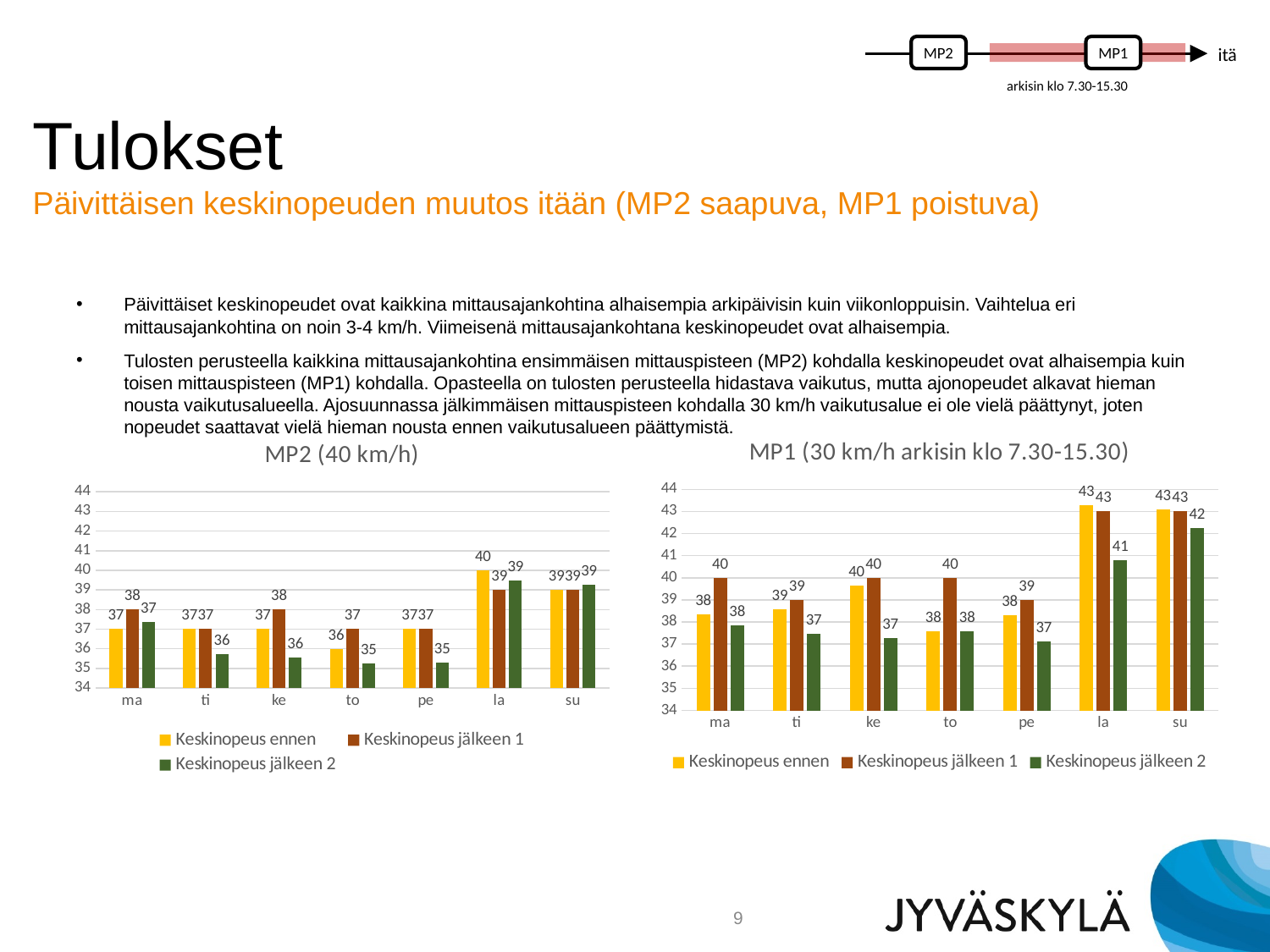
In the MP1 (30 km/h arkisin klo 7.30-15.30) chart, which day has the lowest value for Keskinopeus jälkeen 2? ti, ke and pe (all 37) In the MP2 (40 km/h) chart, what is the value of Keskinopeus jälkeen 1 for ke? 38 In the MP2 (40 km/h) chart, what is the value of Keskinopeus jälkeen 2 for to? 35 How many series does the legend of the MP1 (30 km/h arkisin klo 7.30-15.30) chart list? 3 What type of chart is the MP2 (40 km/h) chart? Bar chart How many days are shown on the x axis of the MP2 (40 km/h) chart? 7 In the MP1 (30 km/h arkisin klo 7.30-15.30) chart, what is the value of Keskinopeus jälkeen 2 for su? 42 In the MP2 (40 km/h) chart, which is larger for ma: Keskinopeus ennen or Keskinopeus jälkeen 1? Keskinopeus jälkeen 1 In the MP1 (30 km/h arkisin klo 7.30-15.30) chart, what is the value of Keskinopeus ennen for ke? 40 In the MP1 (30 km/h arkisin klo 7.30-15.30) chart, what is the difference between Keskinopeus jälkeen 1 and Keskinopeus jälkeen 2 for la? 2 What is the title of the chart on the right side of the slide? MP1 (30 km/h arkisin klo 7.30-15.30) In the MP2 (40 km/h) chart, which day has the highest value for Keskinopeus ennen? la